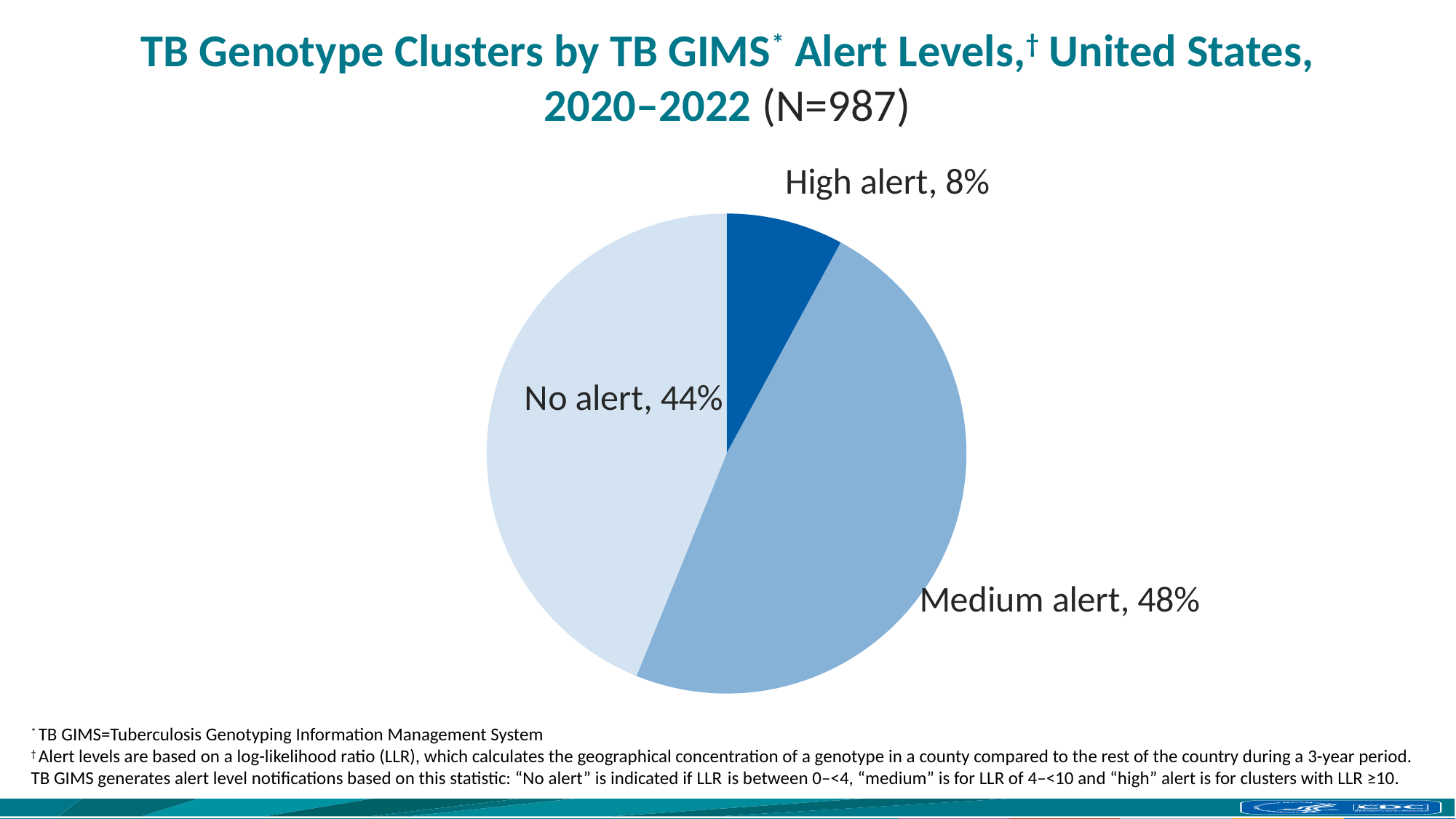
What is the difference in percentage points between the no alert and high alert slices? 36 Which alert level accounts for the smallest share of the pie? High alert Which alert level accounts for the largest share of the pie? Medium alert What kind of chart is shown on the slide? Pie chart Which is larger, the share for no alert or the share for high alert? No alert What percentage of TB genotype clusters had no alert? 44% What percentage of TB genotype clusters had a high alert level? 8% What is the difference in percentage points between the medium alert and no alert slices? 4 What is the total number of TB genotype clusters (N) given in the chart title? 987 What percentage of TB genotype clusters had a medium alert level? 48% What time period does the chart cover? 2020–2022 How many alert level categories are shown in the pie chart? 3